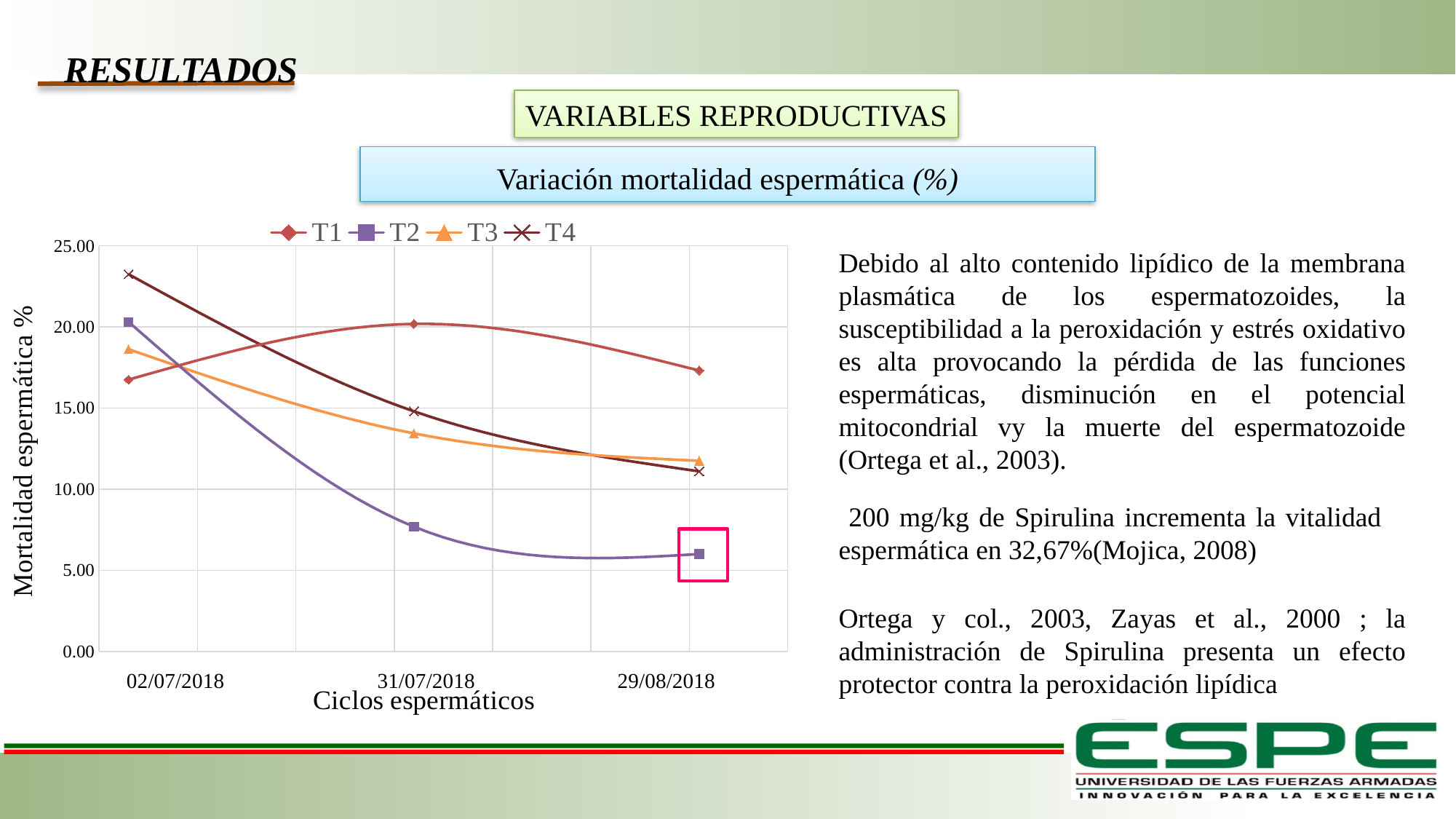
What kind of chart is shown on the slide? line chart Is the value for T2 on 29/08/2018 greater or less than 10.00? less Is the value for T4 on 02/07/2018 greater or less than 20.00? greater Which series has the highest value on 02/07/2018? T4 How many series does the legend list? 4 Which series has the lowest value on 29/08/2018? T2 What is the label of the x axis? Ciclos espermáticos Which series has the lowest value on 31/07/2018? T2 Is the value for T1 on 31/07/2018 greater or less than 15.00? greater How many dates are shown on the x axis? 3 On 31/07/2018, which is larger, the value for T1 or the value for T2? T1 Do the values for T2 rise or fall from 02/07/2018 to 29/08/2018? fall